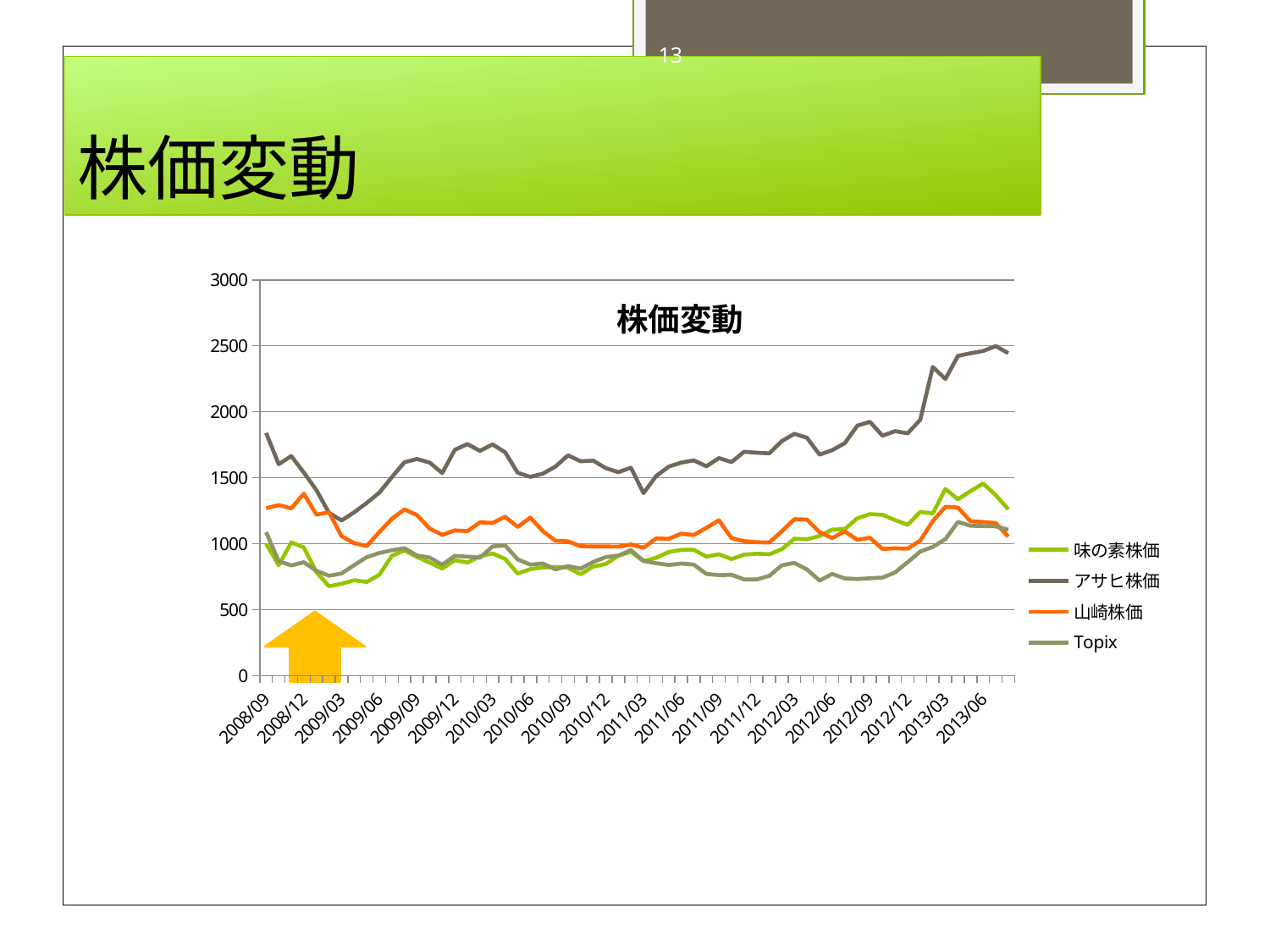
At 2013/06, which is larger: アサヒ株価 or 味の素株価? アサヒ株価 Does アサヒ株価 rise or fall from 2012/12 to 2013/06? rise Is the value of アサヒ株価 at 2013/06 greater or less than 2000? greater What kind of chart is shown on the slide? line chart Is the value of アサヒ株価 at 2008/09 greater or less than 1500? greater What is the title of the chart? 株価変動 Which series has the lowest value at 2012/06? Topix Is the value of Topix at 2009/03 greater or less than 1000? less How many series does the chart's legend list? 4 Which series has the highest value at 2013/06? アサヒ株価 Which series is drawn in orange? 山崎株価